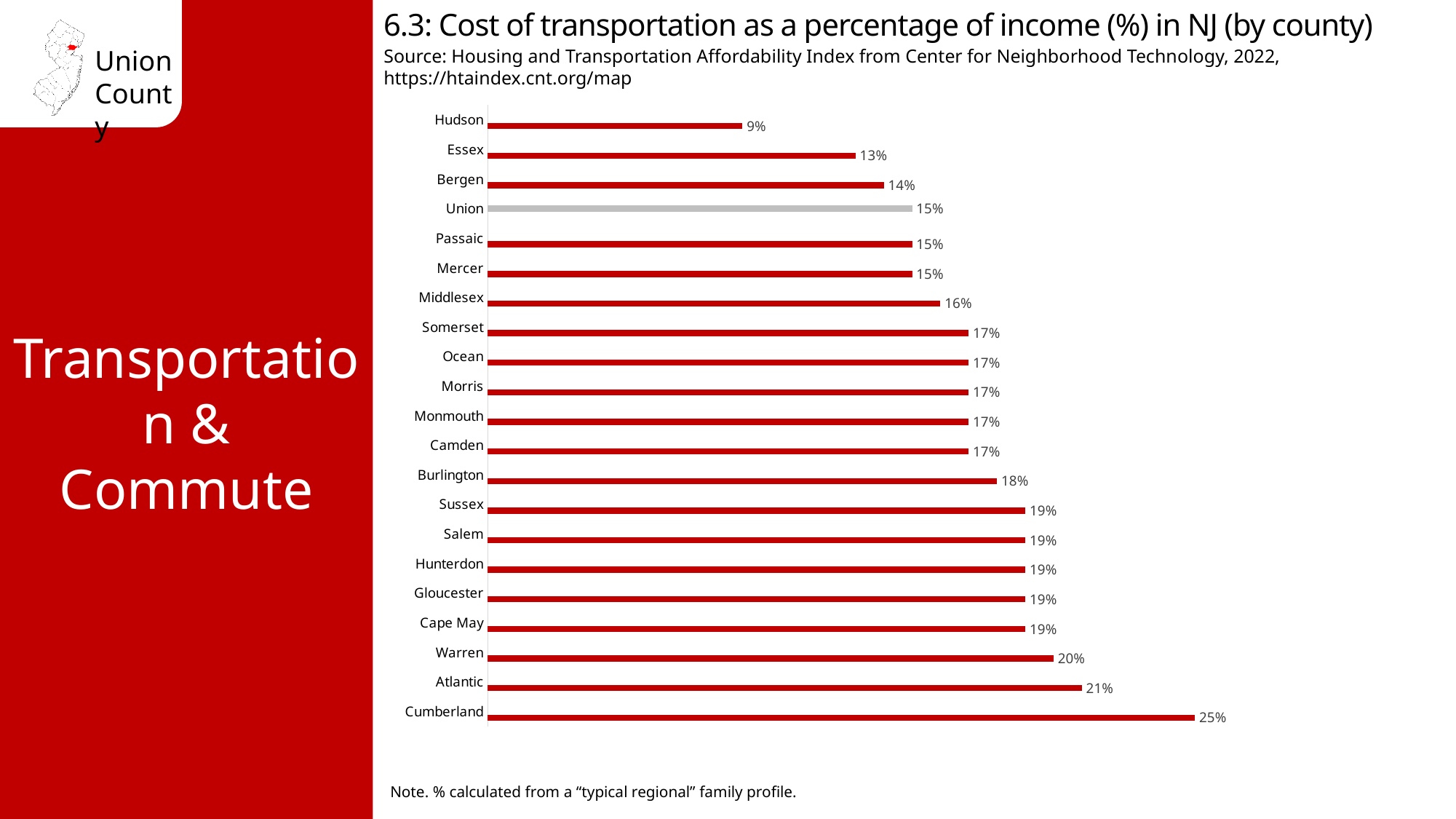
How many counties are shown in the chart? 21 What is the cost of transportation as a percentage of income for Hudson county? 9% Which county has the highest cost of transportation as a percentage of income? Cumberland Which county has the lowest cost of transportation as a percentage of income? Hudson What is the cost of transportation as a percentage of income for Atlantic county? 21% Which county has a larger value, Essex or Middlesex? Middlesex Which county's bar is shown in grey rather than red? Union What is the difference between the values for Cumberland and Hudson? 16% What is the cost of transportation as a percentage of income for Union county? 15% Which county has a larger value, Burlington or Bergen? Burlington What kind of chart is shown on the slide? Bar chart What is the difference between the values for Warren and Union? 5%